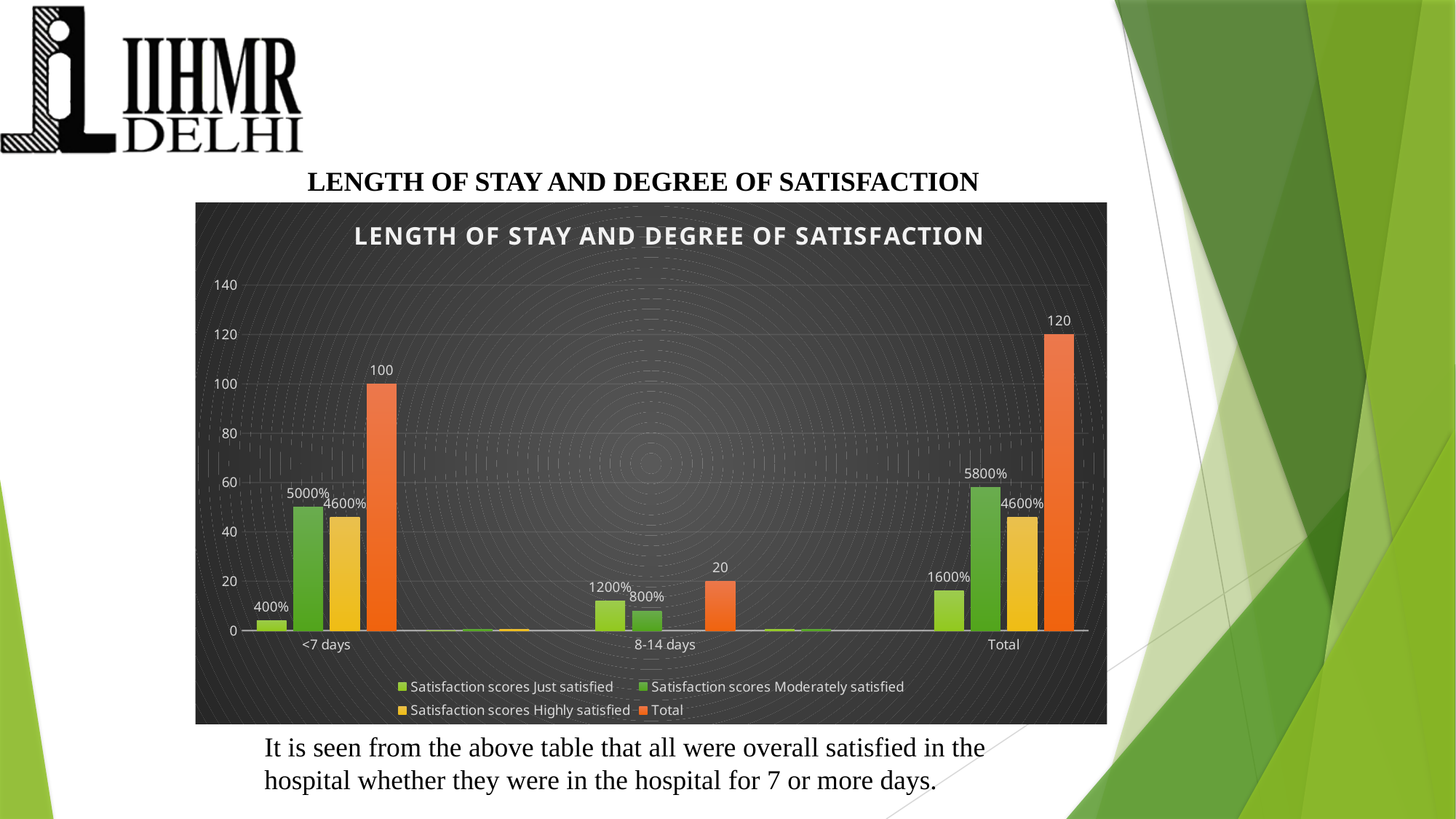
How many categories are shown on the x axis? 3 What is the difference between the Total series values for the Total category and the <7 days category? 20 Which category has the lowest value for the Total series? 8-14 days What is the data label for Satisfaction scores Highly satisfied in the Total category? 4600% Which is larger: the Total series value for <7 days or for 8-14 days? <7 days What is the value of the Total series for the Total category? 120 What kind of chart is shown on the slide? Bar chart What is the data label for Satisfaction scores Moderately satisfied in the <7 days category? 5000% What is the value of the Total series for the <7 days category? 100 What is the data label for Satisfaction scores Just satisfied in the 8-14 days category? 1200% How many series does the legend list? 4 Which category has the highest value for the Total series? Total